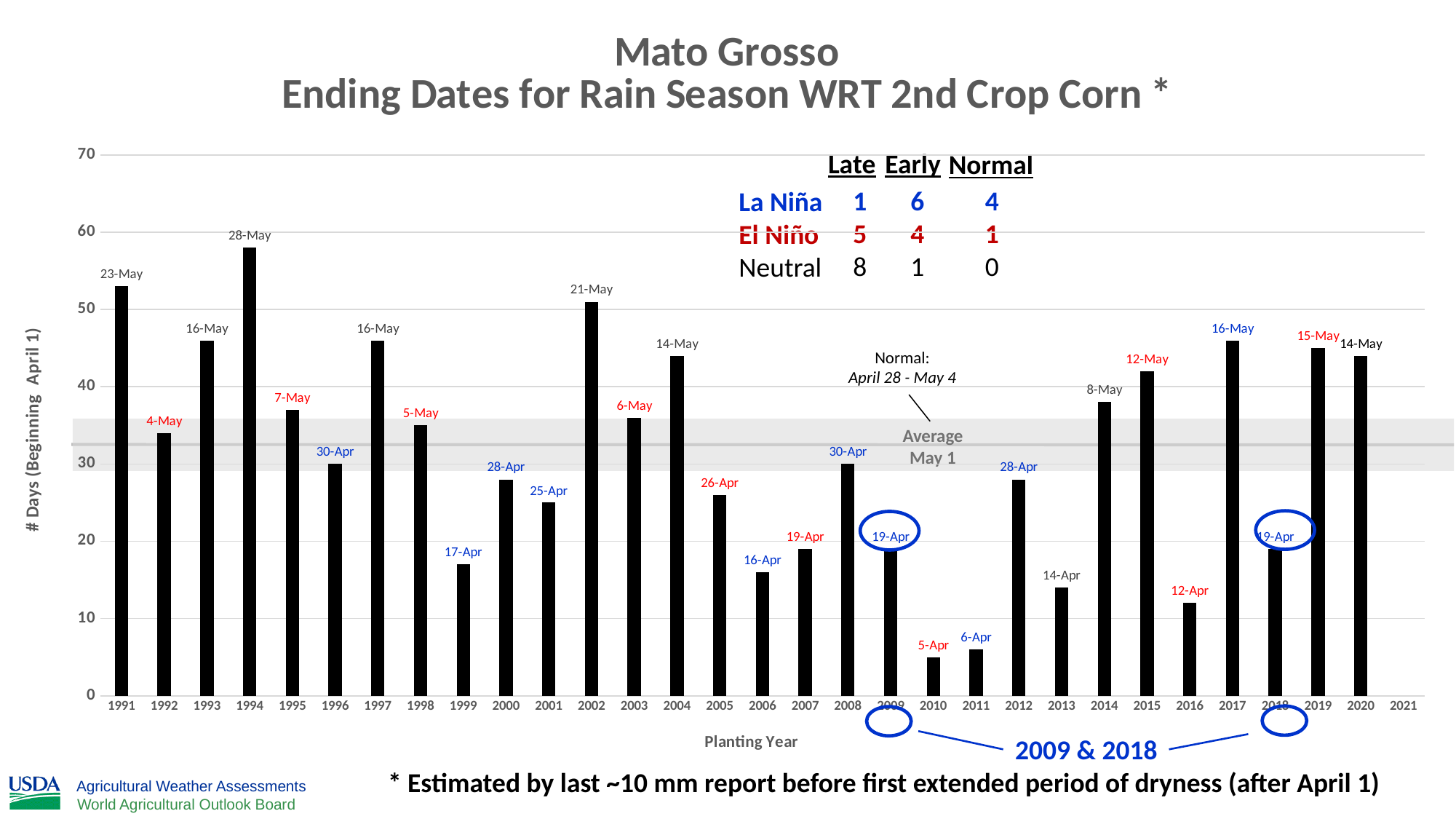
What is the label on the y axis of the chart? # Days (Beginning April 1) Which planting year has the tallest bar (latest ending date)? 1994 What ending date is labelled on the bar for 2002? 21-May What ending date is shown for planting year 2020? 14-May Which two planting years are circled on the chart? 2009 & 2018 Which bar is taller, 1994 or 1991? 1994 What kind of chart is shown on the slide? bar chart Is the value (number of days) for 2013 greater or less than 20? less Is the value (number of days) for 1991 greater or less than 50? greater Which planting year has the shortest bar (earliest ending date)? 2010 What is the data label on the bar for planting year 1994? 28-May What ending date is shown for planting year 2010? 5-Apr